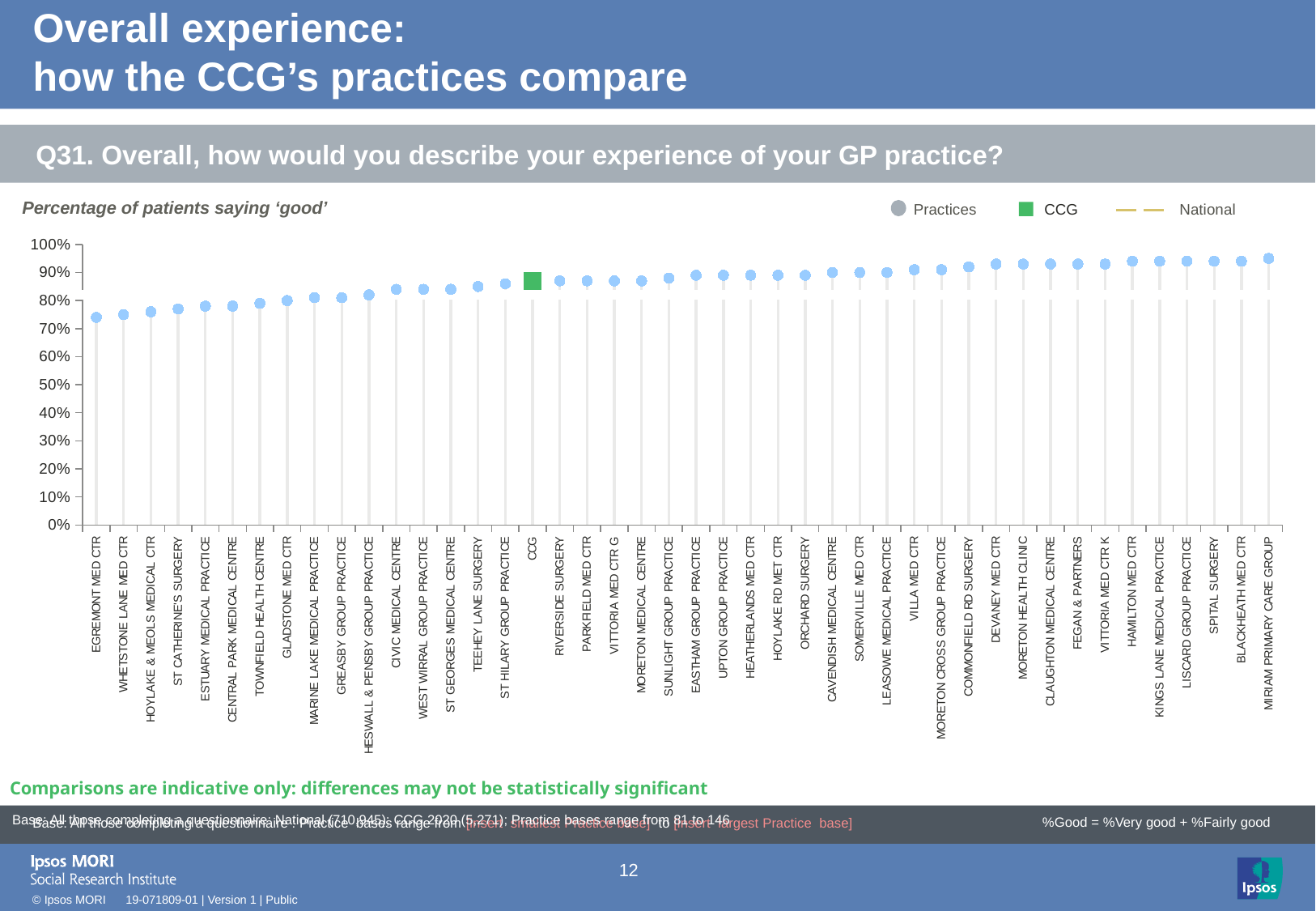
Is the value for CIVIC MEDICAL CENTRE greater or less than 80%? greater Is the value for EGREMONT MED CTR greater or less than 80%? less Is the value for DEVANEY MED CTR greater or less than 90%? greater Do the values rise or fall moving from left to right along the x axis? rise Which practice has the highest percentage of patients saying 'good'? MIRIAM PRIMARY CARE GROUP Which has a higher percentage of patients saying 'good': WHETSTONE LANE MED CTR or SPITAL SURGERY? SPITAL SURGERY What colour is the marker for the CCG point? green How many categories are shown on the x axis, including CCG? 44 Which practice has the lowest percentage of patients saying 'good'? EGREMONT MED CTR How many entries does the legend list? 3